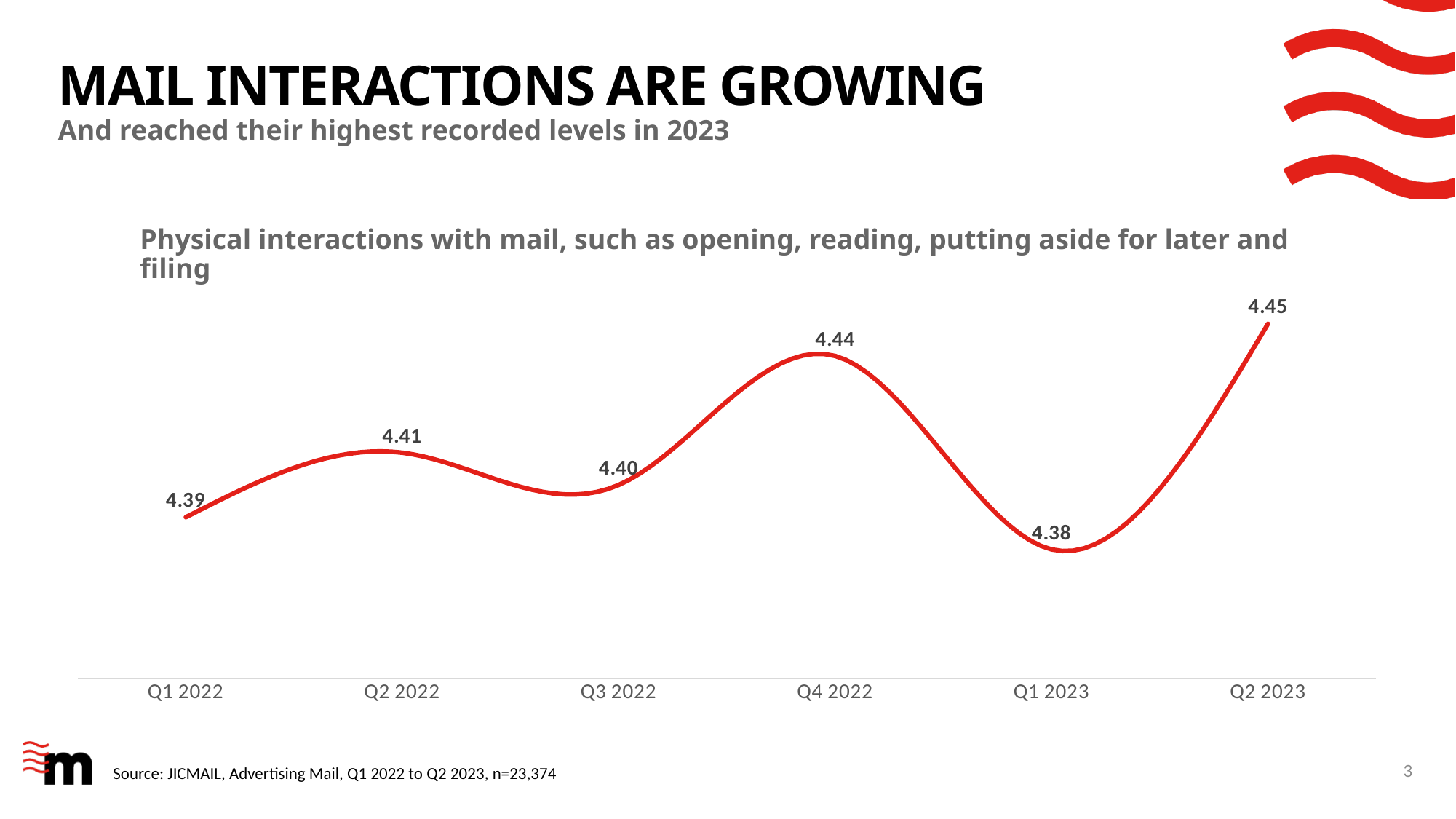
What is the difference between the values for Q4 2022 and Q3 2022? 0.04 Which is larger, the value for Q2 2022 or the value for Q3 2022? Q2 2022 Which quarter has the highest value? Q2 2023 What is the value for Q1 2022? 4.39 How many quarters are plotted on the chart? 6 What is the title of the chart? Physical interactions with mail, such as opening, reading, putting aside for later and filing What kind of chart is shown on the slide? line chart What is the value for Q4 2022? 4.44 Which quarter has the lowest value? Q1 2023 What is the difference between the values for Q2 2023 and Q1 2023? 0.07 What is the value for Q2 2023? 4.45 What is the value for Q1 2023? 4.38